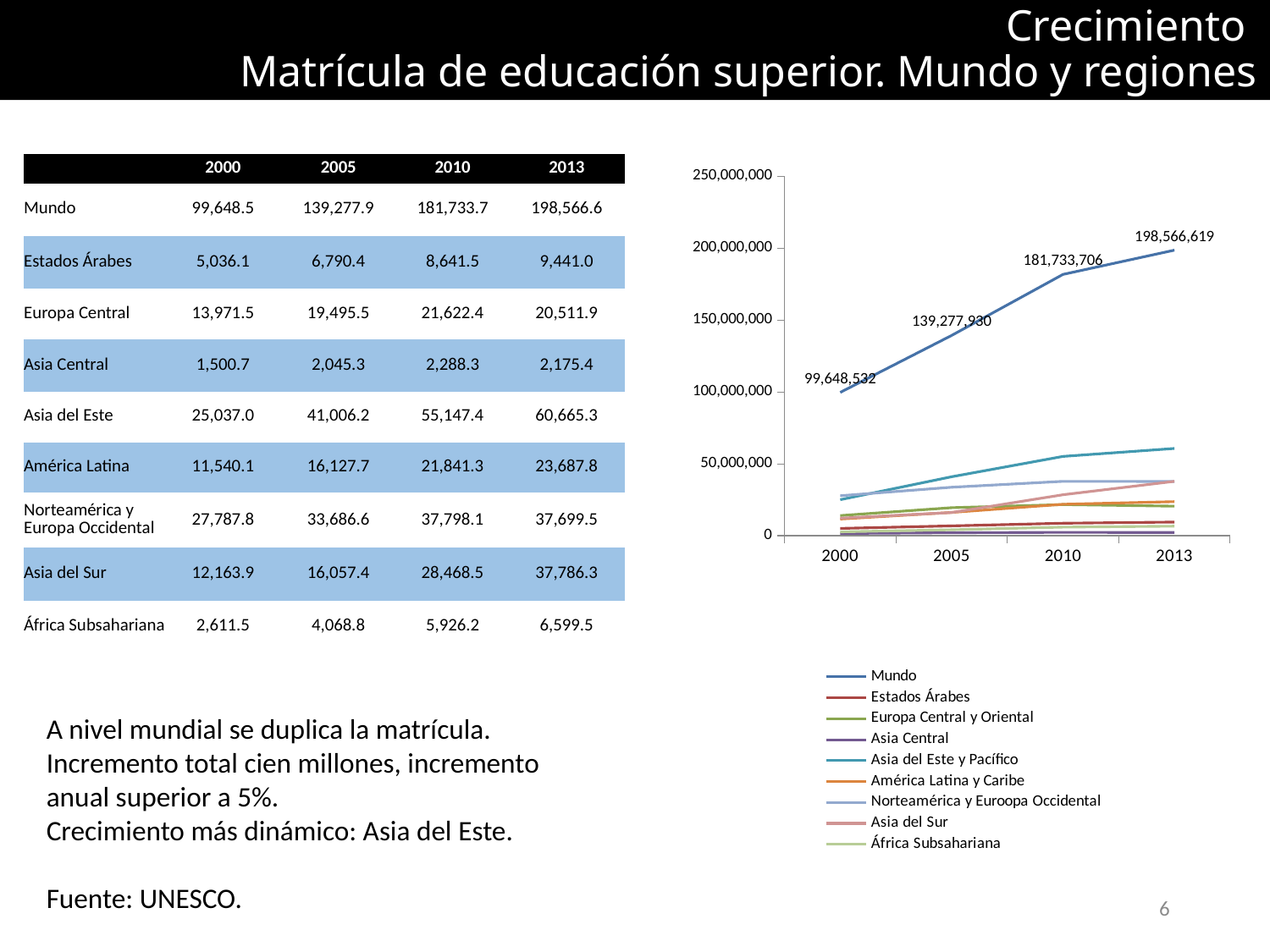
What is the value labelled for Mundo in 2005 on the chart? 139,277,930 How many years are plotted along the x axis of the chart? 4 What is the value labelled for Mundo in 2013 on the chart? 198,566,619 By how much did the Mundo value increase from 2000 to 2013 according to the chart labels? 98,918,087 Does the Mundo line rise or fall from 2000 to 2013? rise What is the value labelled for Mundo in 2010 on the chart? 181,733,706 What type of chart is shown on the slide? line chart How many series does the chart legend list? 9 Which series has the highest values on the chart? Mundo What is the value labelled for Mundo in 2000 on the chart? 99,648,532 Is the value for Norteamérica y Euroopa Occidental in 2013 greater or less than 50,000,000? less Is the value for Asia del Este y Pacífico in 2013 greater or less than 50,000,000? greater